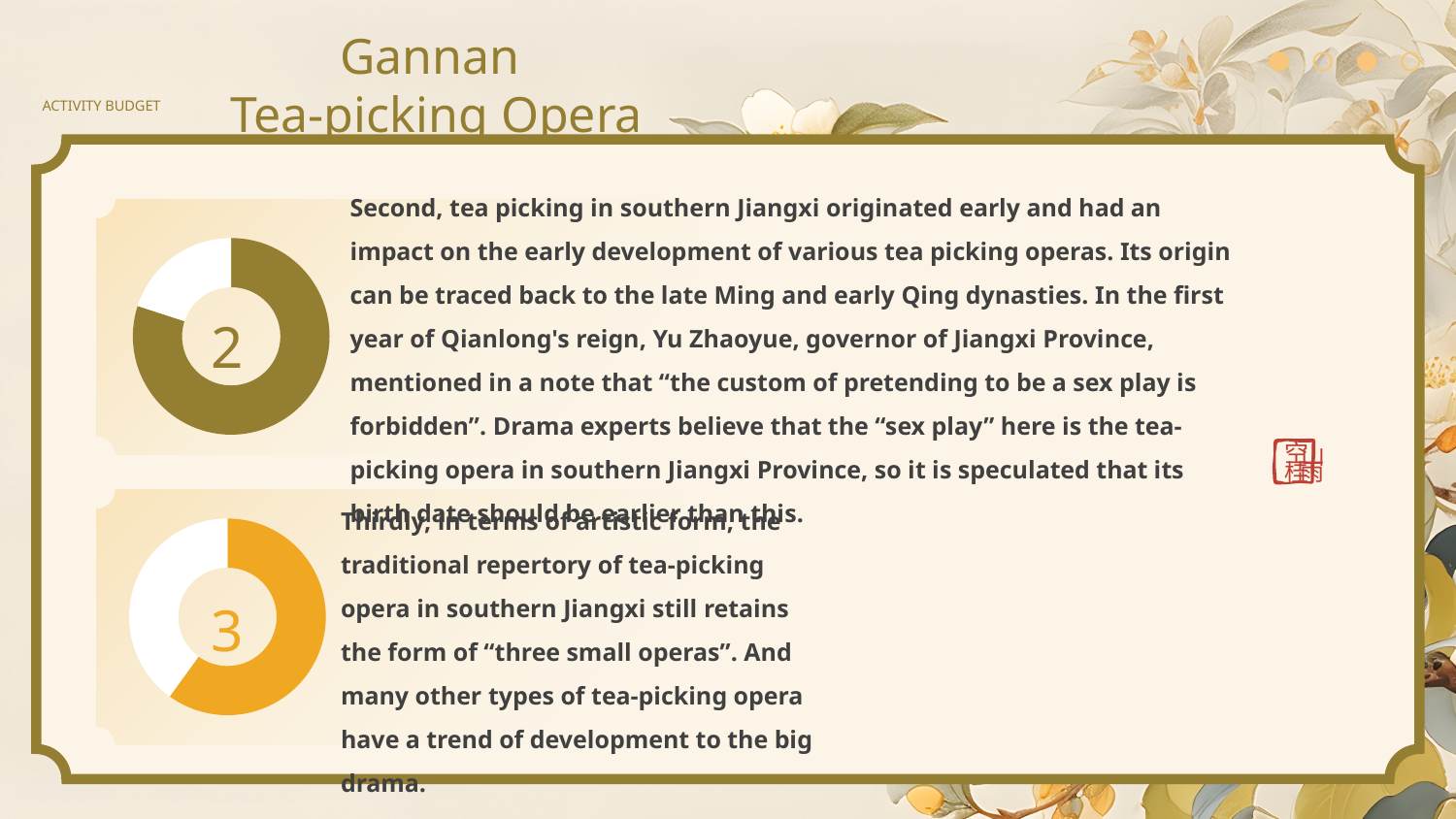
In the bottom doughnut chart, is the orange segment larger or smaller than the white segment? larger How many doughnut charts are on the slide? 2 In the top doughnut chart, is the olive-coloured segment larger or smaller than the white segment? larger What number is displayed in the centre of the top doughnut chart? 2 How many segments does the top doughnut chart have? 2 What number is displayed in the centre of the bottom doughnut chart? 3 What kind of chart is shown at the top left of the slide? doughnut chart How many segments does the bottom doughnut chart have? 2